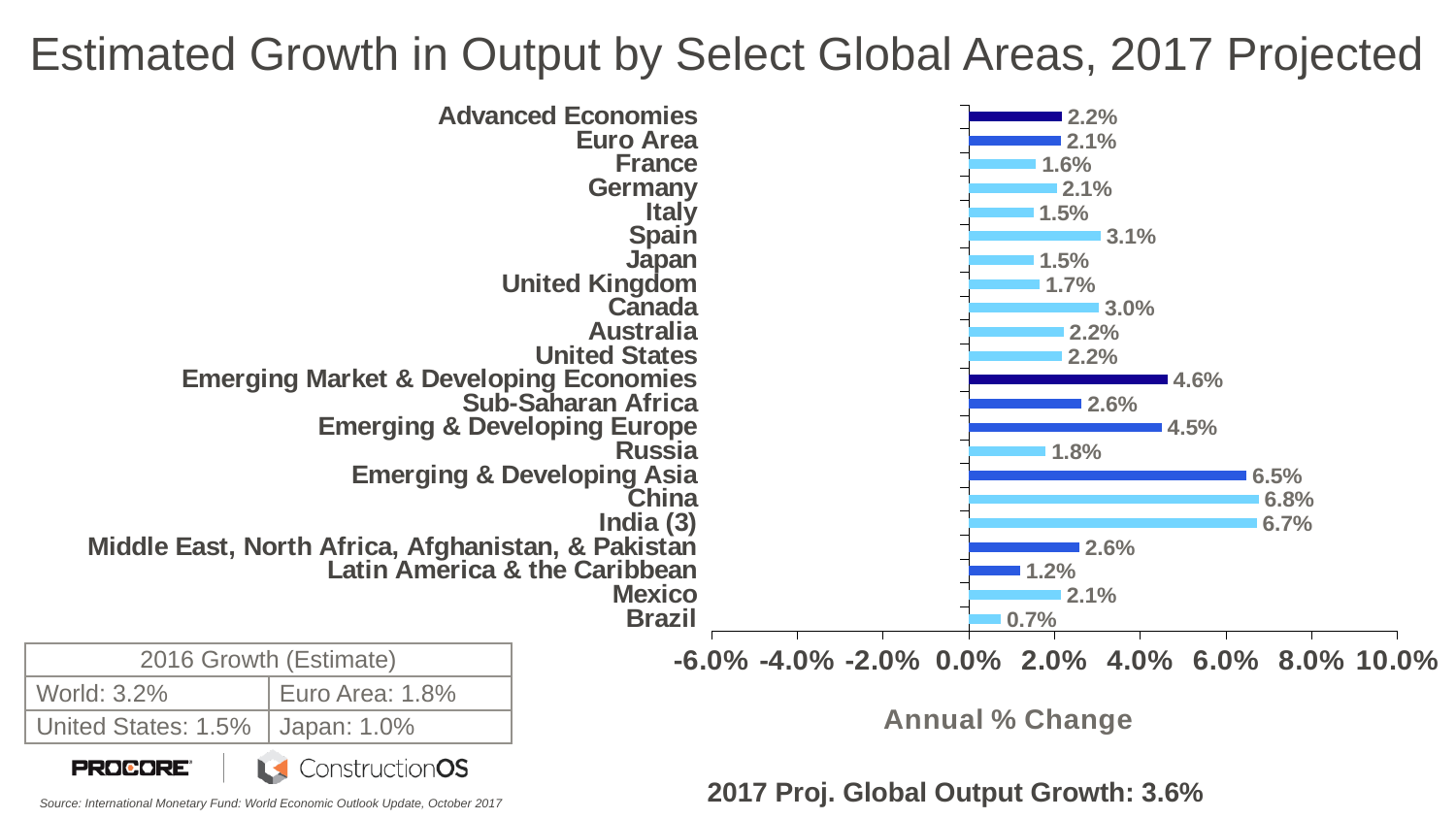
What is the projected 2017 growth value for Spain? 3.1% What is the projected 2017 growth value for Latin America & the Caribbean? 1.2% What type of chart is shown on the slide? Bar chart Which has a higher projected growth, Canada or the United Kingdom? Canada Which area has the lowest projected growth in the chart? Brazil What is the projected 2017 growth value for China? 6.8% What is the projected 2017 growth value for Emerging Market & Developing Economies? 4.6% What is the difference between the projected growth for India (3) and Russia? 4.9% How many areas are plotted in the chart? 22 Is the value for Emerging & Developing Asia greater or less than 6.0%? greater What is the label of the horizontal axis of the chart? Annual % Change Which area has the highest projected growth in the chart? China